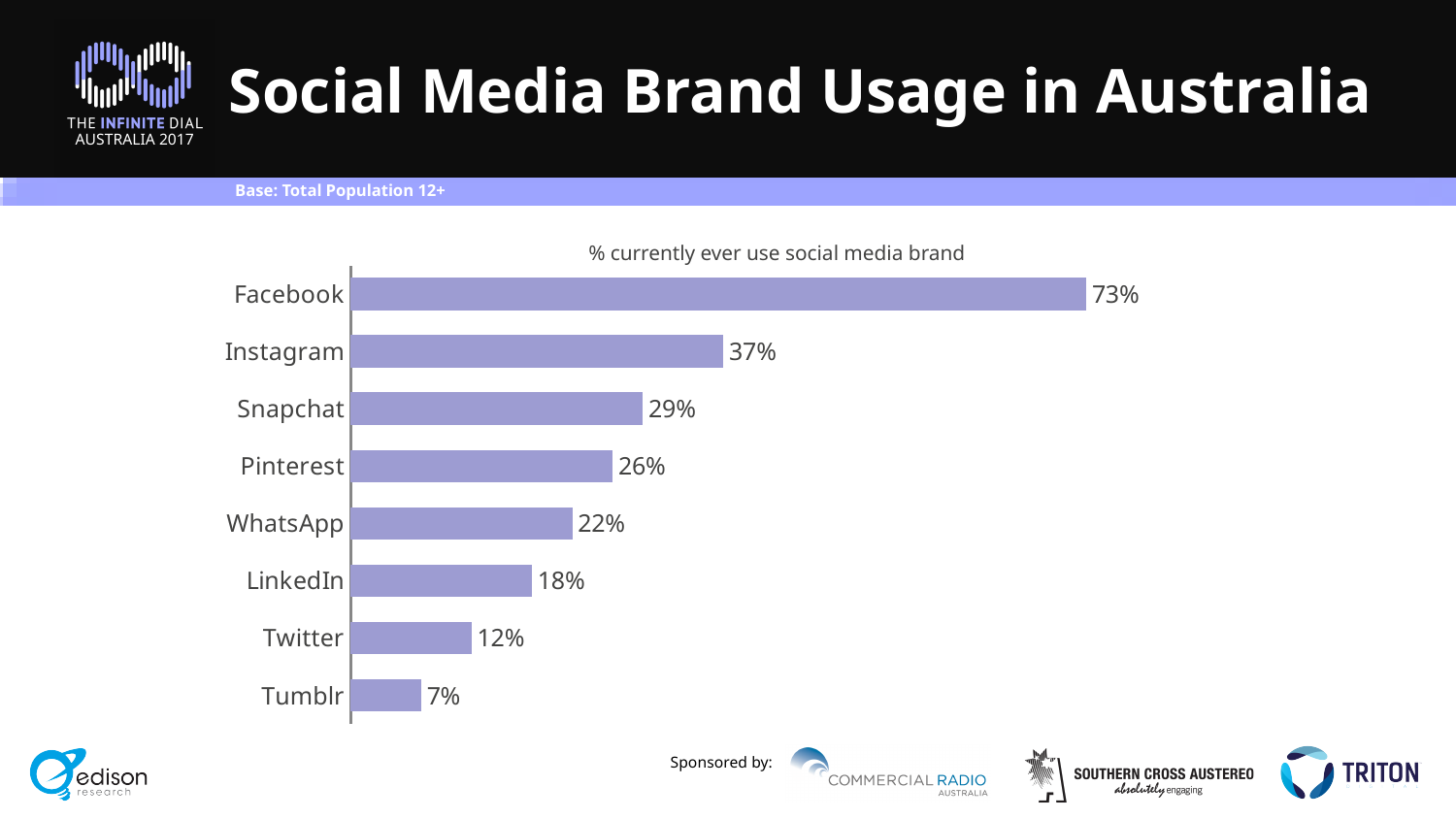
What is the chart's title? % currently ever use social media brand Which social media brand has the lowest usage? Tumblr How many social media brands are shown in the chart? 8 What percentage of Australians currently ever use Facebook? 73% Do the values rise or fall going from the top bar to the bottom bar? Fall Which social media brand has the highest usage? Facebook Which has a higher value, Twitter or LinkedIn? LinkedIn What is the value shown for WhatsApp? 22% What kind of chart is shown on the slide? Bar chart What is the difference between the values for Snapchat and Pinterest? 3% What is the difference between the values for Facebook and Instagram? 36% What is the value shown for LinkedIn? 18%